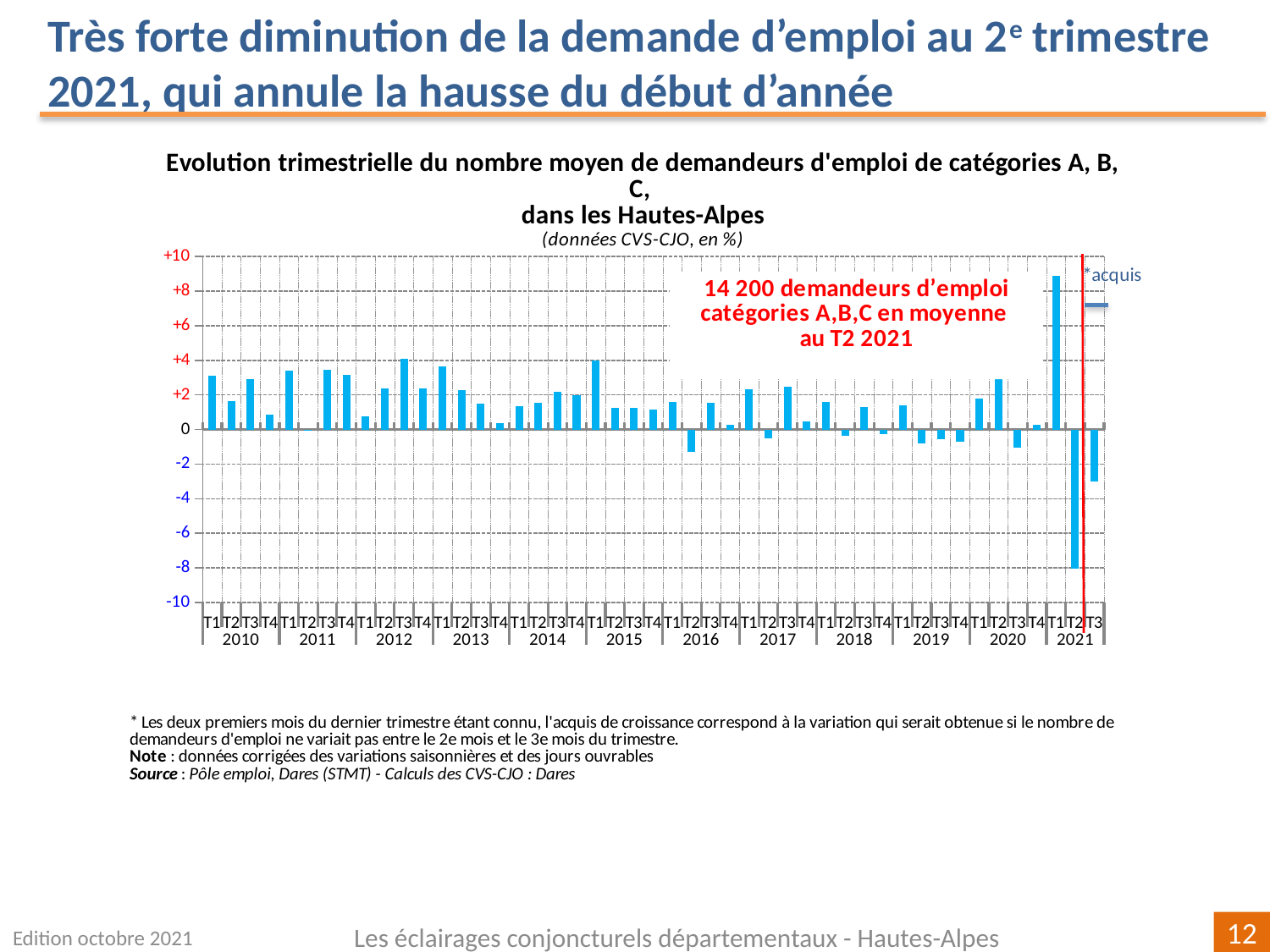
According to the annotation on the chart, how many demandeurs d'emploi catégories A,B,C were there on average in T2 2021? 14 200 Is the value for T2 2021 greater or less than -6? less Is the value for T3 2021 greater or less than -2? less Which quarter has the highest value in the chart? T1 2021 Is the value for T1 2010 greater or less than +2? greater Which quarter has the lowest value in the chart? T2 2021 Does the value rise or fall from T1 2021 to T2 2021? fall What kind of chart is shown on the slide? bar chart How many years are labelled on the x axis of the chart? 12 Which is larger, the value for T1 2021 or the value for T1 2010? T1 2021